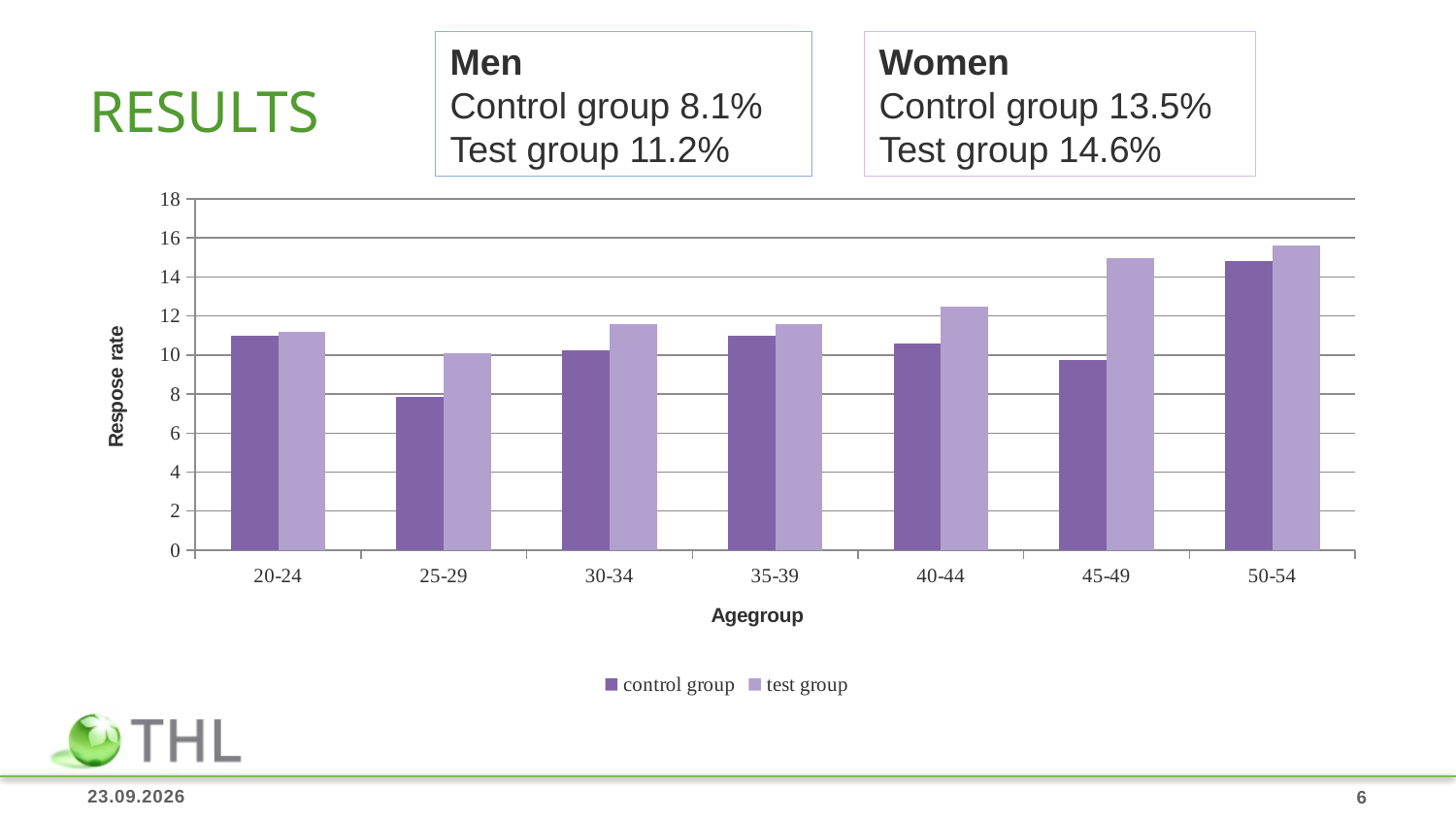
Which age group has the lowest test group response rate? 25-29 Is the control group value for the 50-54 age group greater or less than 14? greater For the 45-49 age group, which is larger: the control group or the test group response rate? test group What kind of chart is shown on the slide? bar chart What is the title of the x axis of the chart? Agegroup Is the control group value for the 25-29 age group greater or less than 10? less For the 25-29 age group, which is larger: the control group or the test group response rate? test group How many age groups are shown on the x axis of the chart? 7 Which age group has the highest control group response rate? 50-54 Which age group has the lowest control group response rate? 25-29 How many series does the chart legend list? 2 Is the test group value for the 45-49 age group greater or less than 14? greater